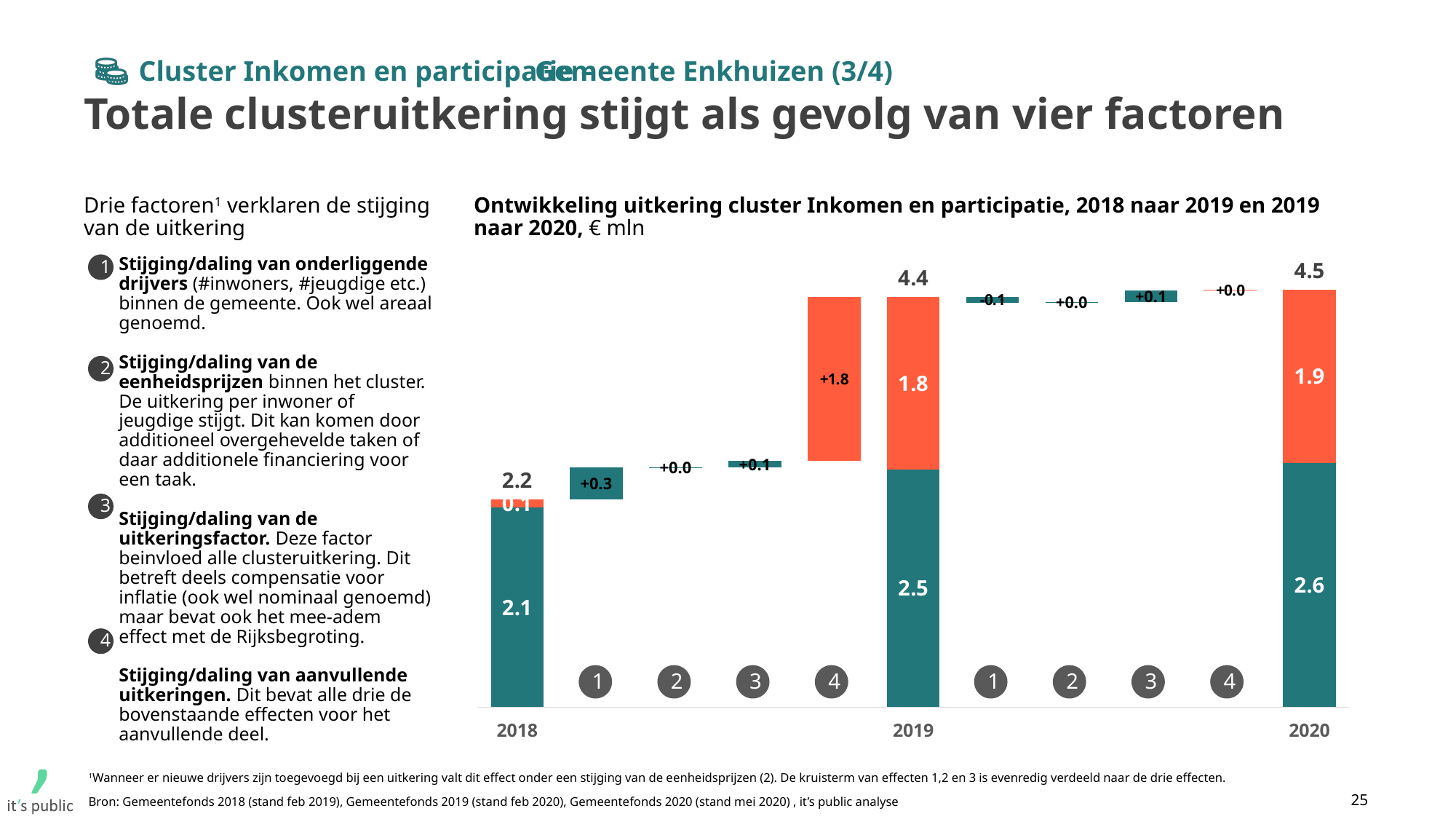
What is the value of the teal (lower) segment of the 2019 bar? 2.5 What is the effect of factor 1 in the step from 2018 to 2019? +0.3 Do the yearly totals rise or fall from 2018 to 2020? rise What is the difference between the total for 2020 and the total for 2018? 2.3 What is the effect of factor 1 in the step from 2019 to 2020? -0.1 What is the effect of factor 4 in the step from 2018 to 2019? +1.8 Which year has the highest total uitkering? 2020 What kind of chart is shown on the slide? bar chart (waterfall) What is the value of the orange (upper) segment of the 2020 bar? 1.9 What is the total uitkering shown for 2019? 4.4 What is the total uitkering shown for 2020? 4.5 What is the total uitkering shown for 2018? 2.2